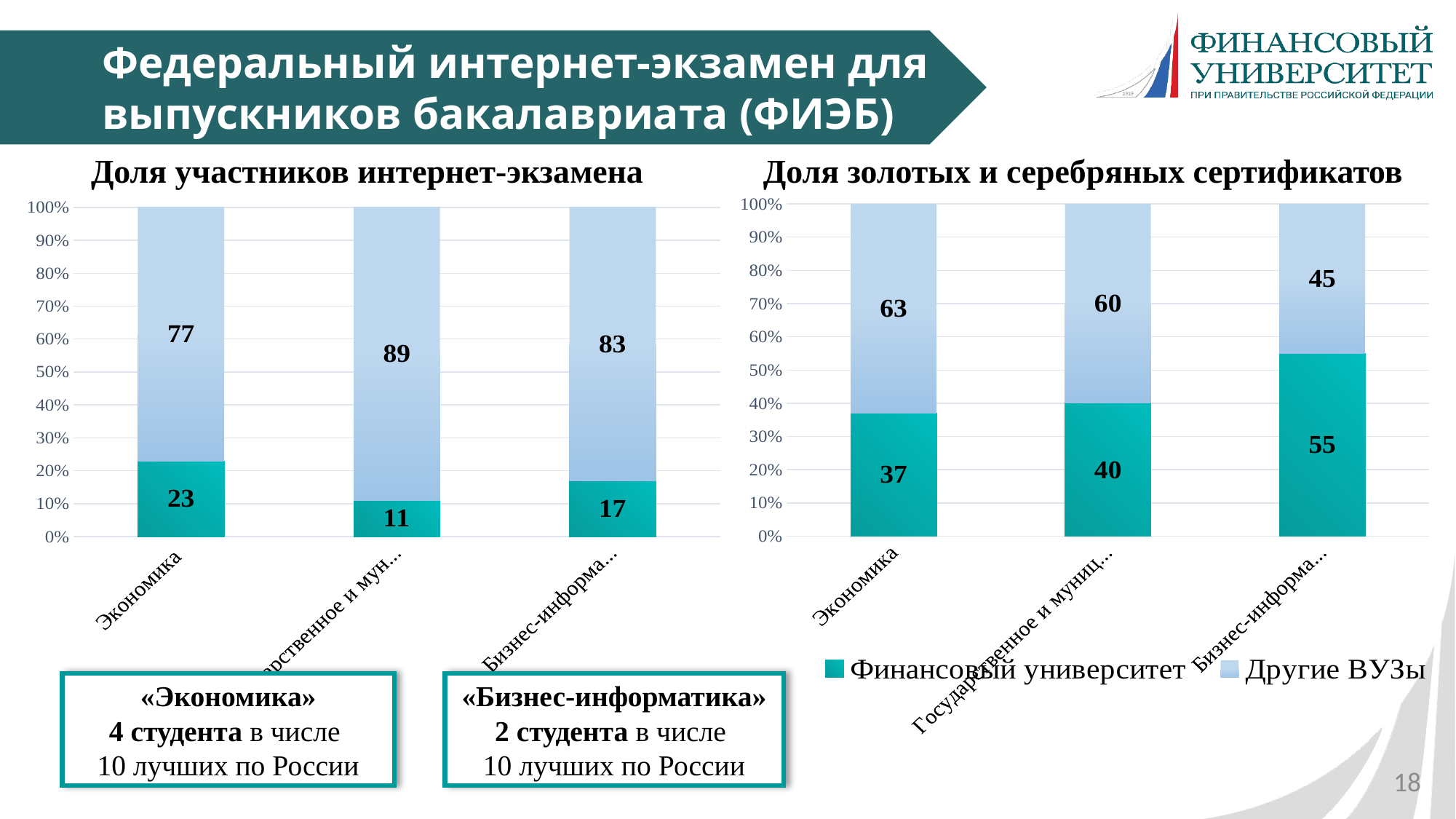
In the left chart 'Доля участников интернет-экзамена', which is larger for Финансовый университет: Экономика or Бизнес-информатика? Экономика In the right chart 'Доля золотых и серебряных сертификатов', what is the value for Другие ВУЗы in the third (Бизнес-информатика) category? 45 How many series does the legend list for the charts on this slide? 2 How many categories are shown in the left chart 'Доля участников интернет-экзамена'? 3 In the left chart 'Доля участников интернет-экзамена', what is the value for Финансовый университет in the Экономика category? 23 What type of chart is the right chart 'Доля золотых и серебряных сертификатов'? stacked bar chart In the left chart 'Доля участников интернет-экзамена', what is the value for Другие ВУЗы in the Экономика category? 77 In the right chart 'Доля золотых и серебряных сертификатов', what is the total of the stacked bar for Экономика? 100 In the right chart 'Доля золотых и серебряных сертификатов', what is the difference between the Другие ВУЗы and Финансовый университет values for Экономика? 26 In the right chart 'Доля золотых и серебряных сертификатов', what is the value for Финансовый университет in the Экономика category? 37 In the right chart 'Доля золотых и серебряных сертификатов', which category has the highest value for Финансовый университет? Бизнес-информатика In the left chart 'Доля участников интернет-экзамена', which bar has the lowest value for Финансовый университет? the middle bar (Государственное и мун...)